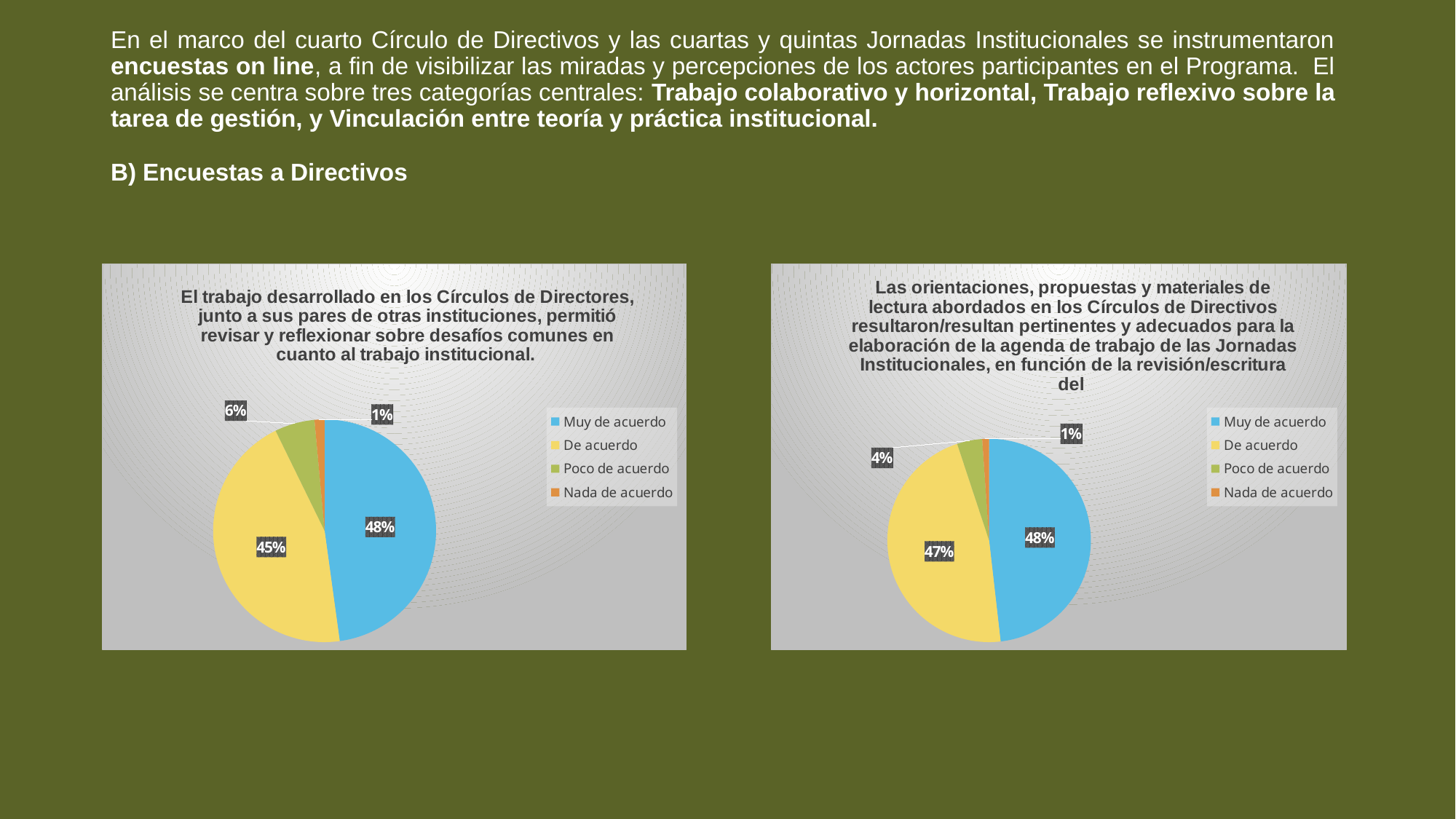
How many entries does the legend of the right chart list? 4 In the left pie chart, what percentage is shown for 'Muy de acuerdo'? 48% In the left pie chart, which category has the smallest share? Nada de acuerdo In the left pie chart, what percentage is shown for 'De acuerdo'? 45% In the right pie chart, what percentage is shown for 'De acuerdo'? 47% In the left pie chart, what is the difference between the 'Muy de acuerdo' and 'De acuerdo' shares? 3% In the right pie chart, what percentage is shown for 'Poco de acuerdo'? 4% What type of chart is the left chart? Pie chart In the right pie chart, what percentage is shown for 'Nada de acuerdo'? 1% In the left pie chart, which is larger: 'Poco de acuerdo' or 'Nada de acuerdo'? Poco de acuerdo In the left pie chart, what percentage is shown for 'Poco de acuerdo'? 6% In the right pie chart, which category has the largest share? Muy de acuerdo